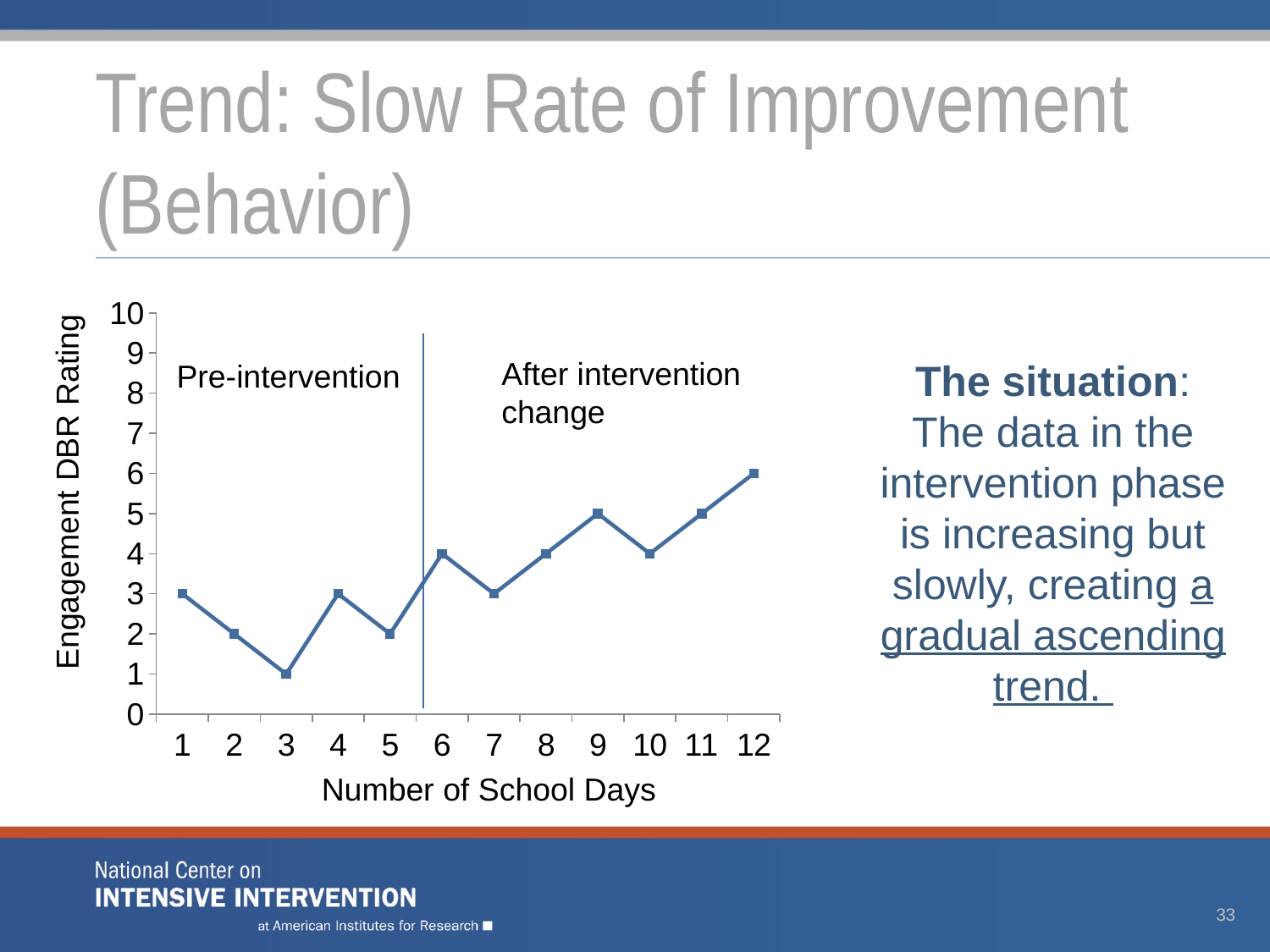
What is the difference between the Engagement DBR Rating on day 12 and on day 1? 3 Does the Engagement DBR Rating generally rise or fall across the 'After intervention change' phase (days 6 to 12)? Rise What is the label of the y axis? Engagement DBR Rating How many school days are plotted on the x axis? 12 Which has a higher Engagement DBR Rating, school day 6 or school day 7? School day 6 What is the Engagement DBR Rating on school day 9? 5 On which school day is the Engagement DBR Rating lowest? 3 What is the label of the x axis? Number of School Days What is the Engagement DBR Rating on school day 3? 1 What type of chart is shown on the slide? Line chart What is the Engagement DBR Rating on school day 12? 6 On which school day is the Engagement DBR Rating highest? 12